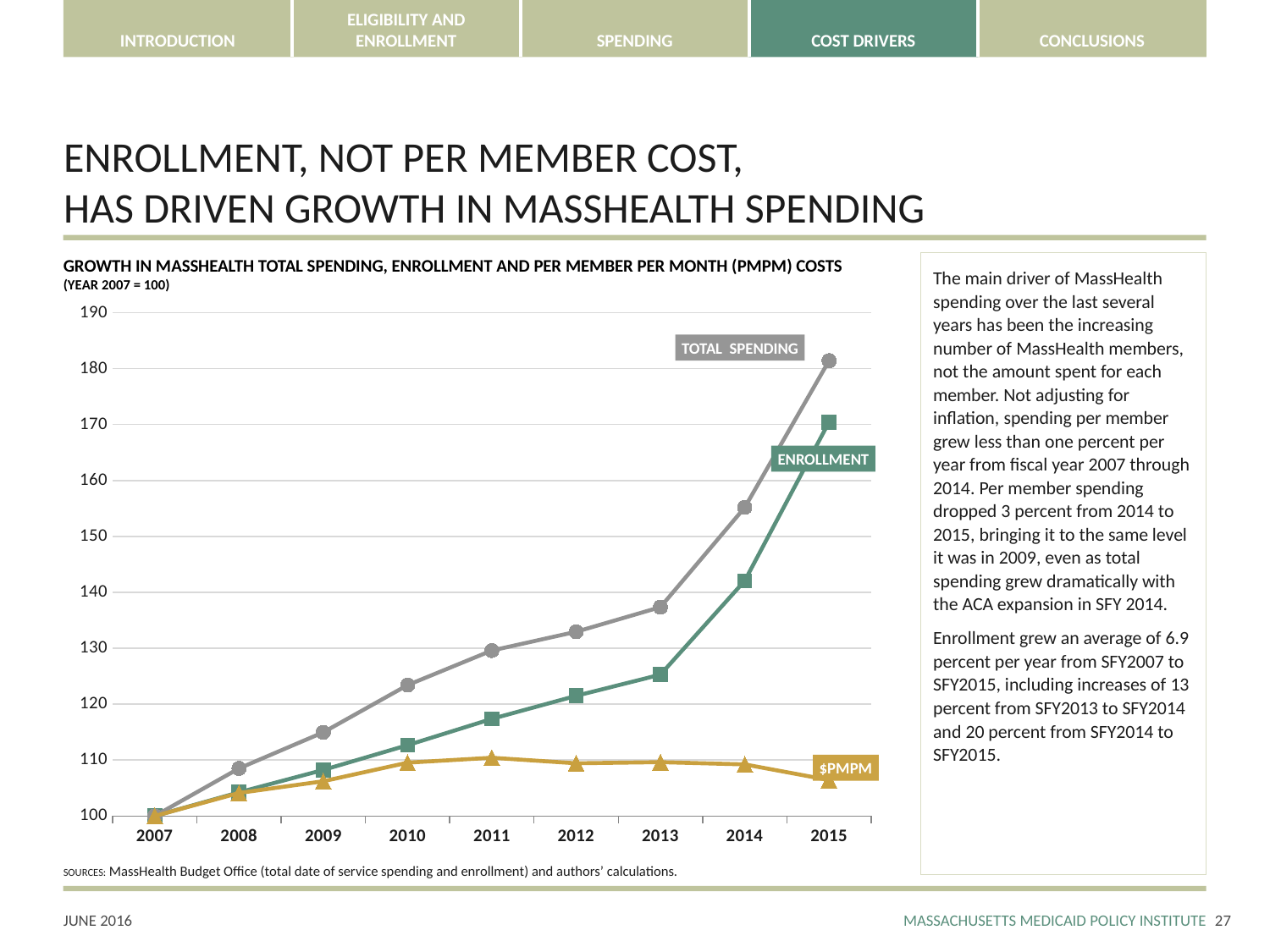
How many series are plotted on the chart? 3 Does the Total Spending series rise or fall from 2007 to 2015? rise What base year is the index set to 100, according to the chart subtitle? 2007 Which is larger in 2013, Total Spending or Enrollment? Total Spending Is the value for Total Spending in 2015 greater or less than 170? greater Which series has the lowest value in 2015? $PMPM Is the value for Enrollment in 2015 greater or less than 160? greater How many years are shown along the x axis of the chart? 9 Which series has the highest value in 2015? Total Spending Is the value for $PMPM in 2015 greater or less than 110? less What is the index value for Total Spending in 2007? 100 What kind of chart is shown on the slide? line chart